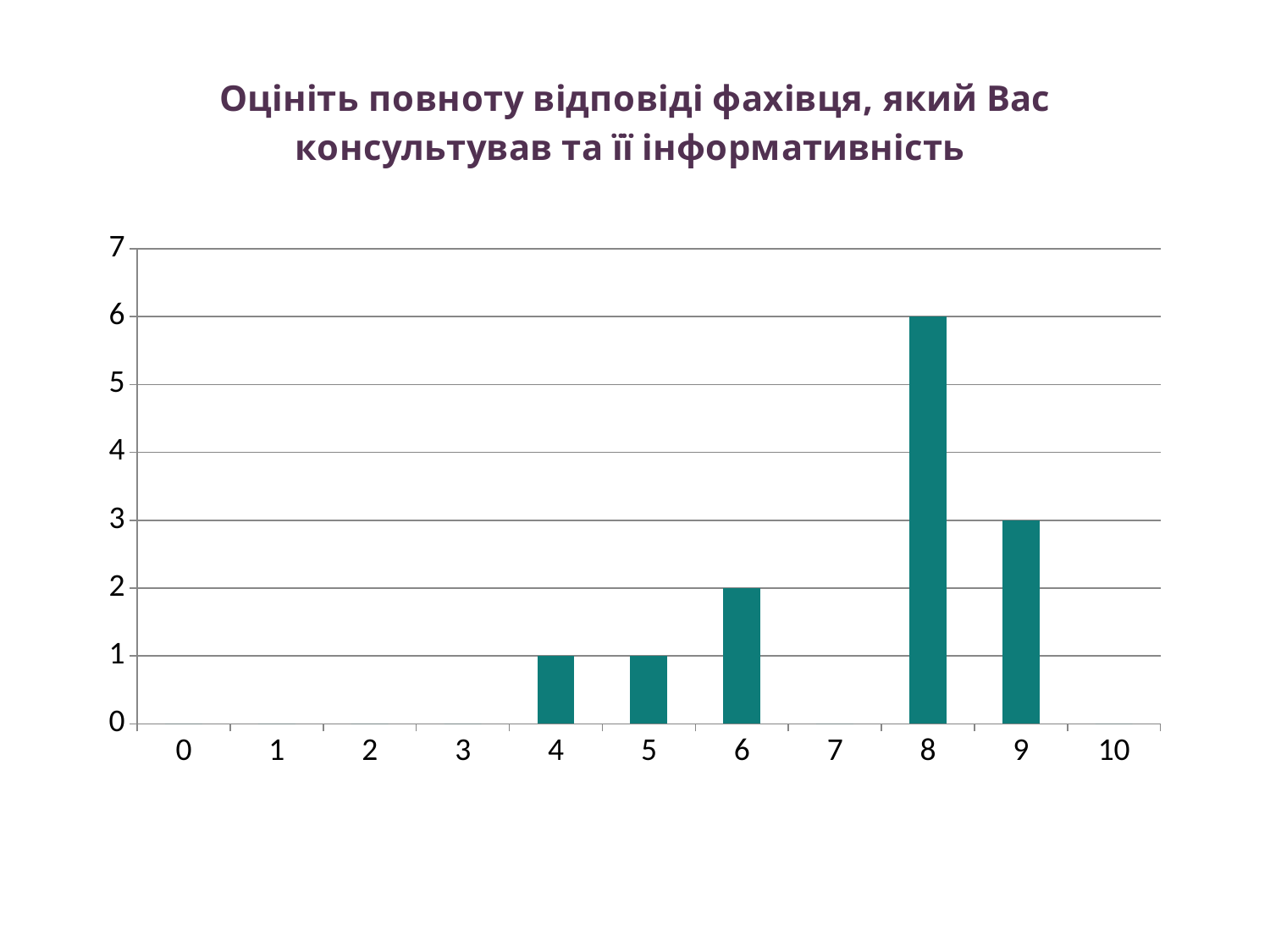
What type of chart is shown on the slide? bar chart What is the value for category 8? 6 Is the value for category 8 greater or less than 5? greater Which category has the highest value? 8 What is the value for category 4? 1 How many categories have a visible bar? 5 What is the value for category 9? 3 What is the value for category 6? 2 Which is larger, the value for category 6 or the value for category 9? 9 What is the difference between the values for categories 8 and 9? 3 What is the title of the chart? Оцініть повноту відповіді фахівця, який Вас консультував та її інформативність How many categories are shown on the x axis? 11